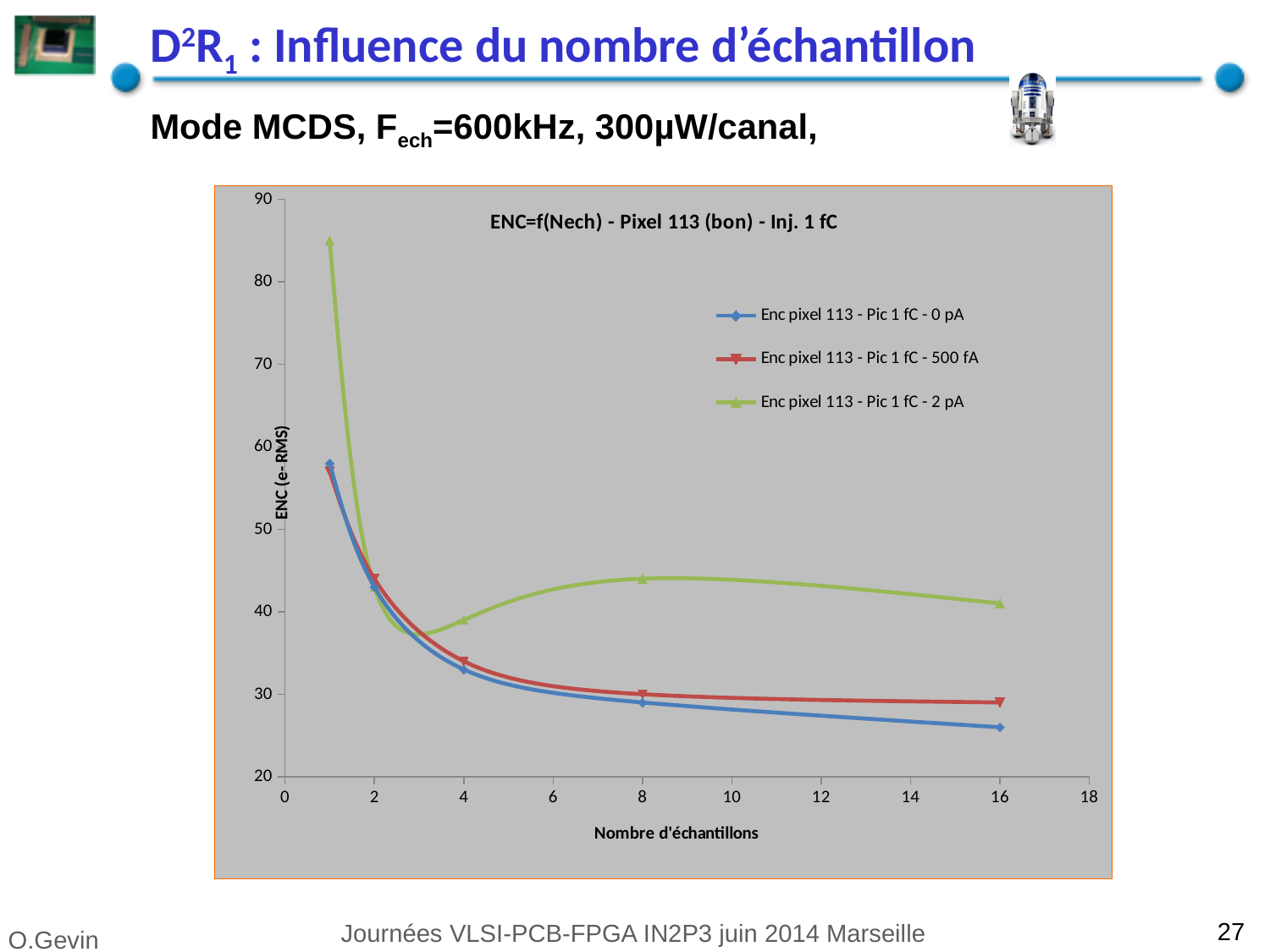
Is the value of the 'Enc pixel 113 - Pic 1 fC - 2 pA' series at 8 samples greater or less than 40? greater Which series has the highest ENC at 1 sample? Enc pixel 113 - Pic 1 fC - 2 pA At 16 samples, which series has the higher ENC: 'Enc pixel 113 - Pic 1 fC - 2 pA' or 'Enc pixel 113 - Pic 1 fC - 0 pA'? Enc pixel 113 - Pic 1 fC - 2 pA Which series has the lowest ENC at 16 samples? Enc pixel 113 - Pic 1 fC - 0 pA How many series does the legend list? 3 How many data points are plotted for the 'Enc pixel 113 - Pic 1 fC - 0 pA' series? 5 Is the value of the 'Enc pixel 113 - Pic 1 fC - 2 pA' series at 1 sample greater or less than 80? greater Is the value of the 'Enc pixel 113 - Pic 1 fC - 500 fA' series at 4 samples greater or less than 30? greater What kind of chart is shown on the slide? line chart Does the 'Enc pixel 113 - Pic 1 fC - 0 pA' series rise or fall as the number of samples increases? fall What is the title of the chart? ENC=f(Nech) - Pixel 113 (bon) - Inj. 1 fC